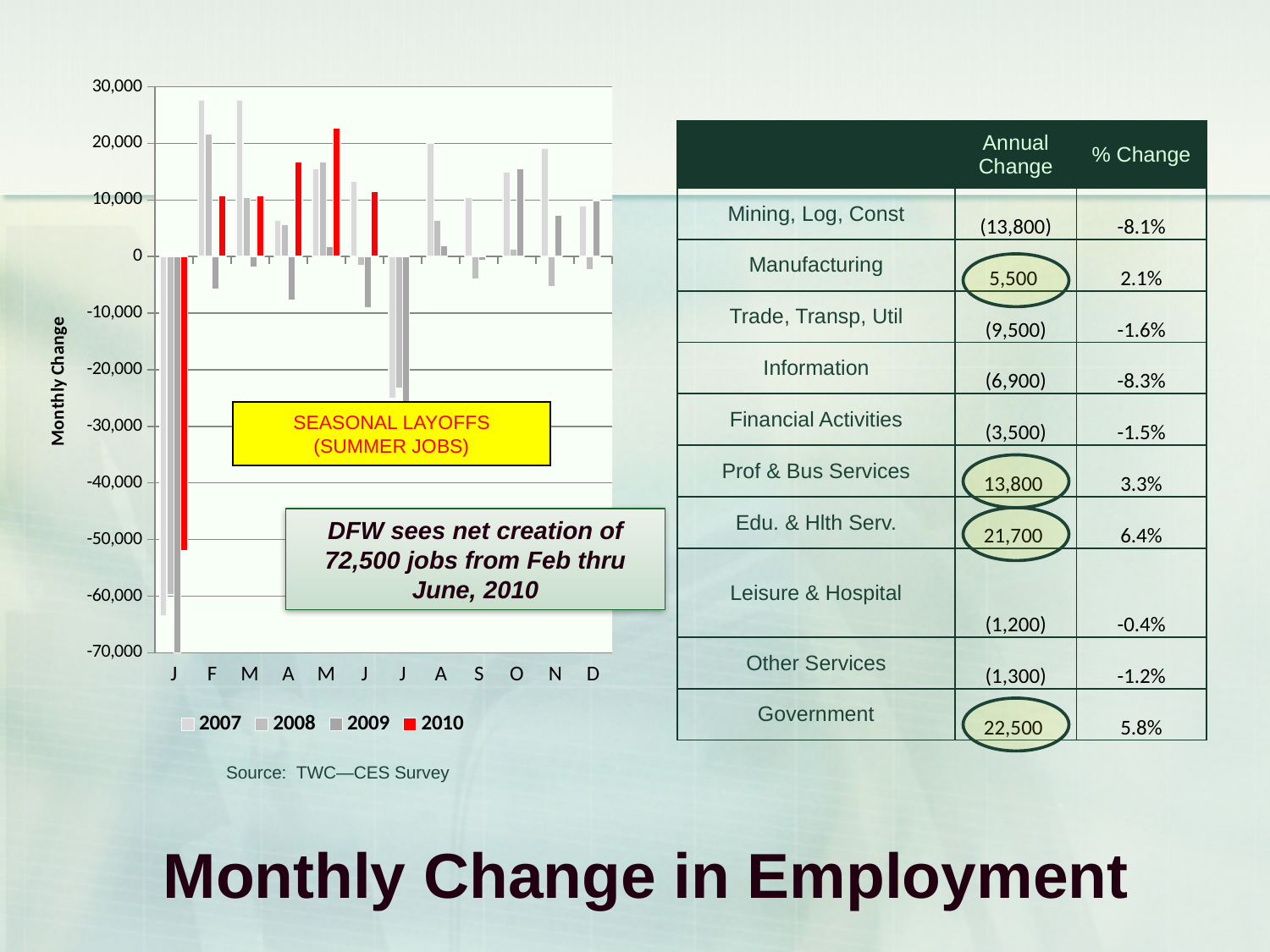
Is the 2009 value for July greater or less than -20,000? less What kind of chart is shown on the slide? bar chart Is the 2009 value for January greater or less than -60,000? less Which month has the highest 2010 bar in the chart? May How many series does the chart's legend list? 4 Which month has the lowest 2010 bar in the chart? January Is the 2010 value for January greater or less than -40,000? less Which years are listed in the chart's legend? 2007, 2008, 2009, 2010 How many month categories are shown along the x axis of the chart? 12 What is the title of the chart's vertical axis? Monthly Change Which is larger in the chart: the 2010 value for May or the 2010 value for February? May